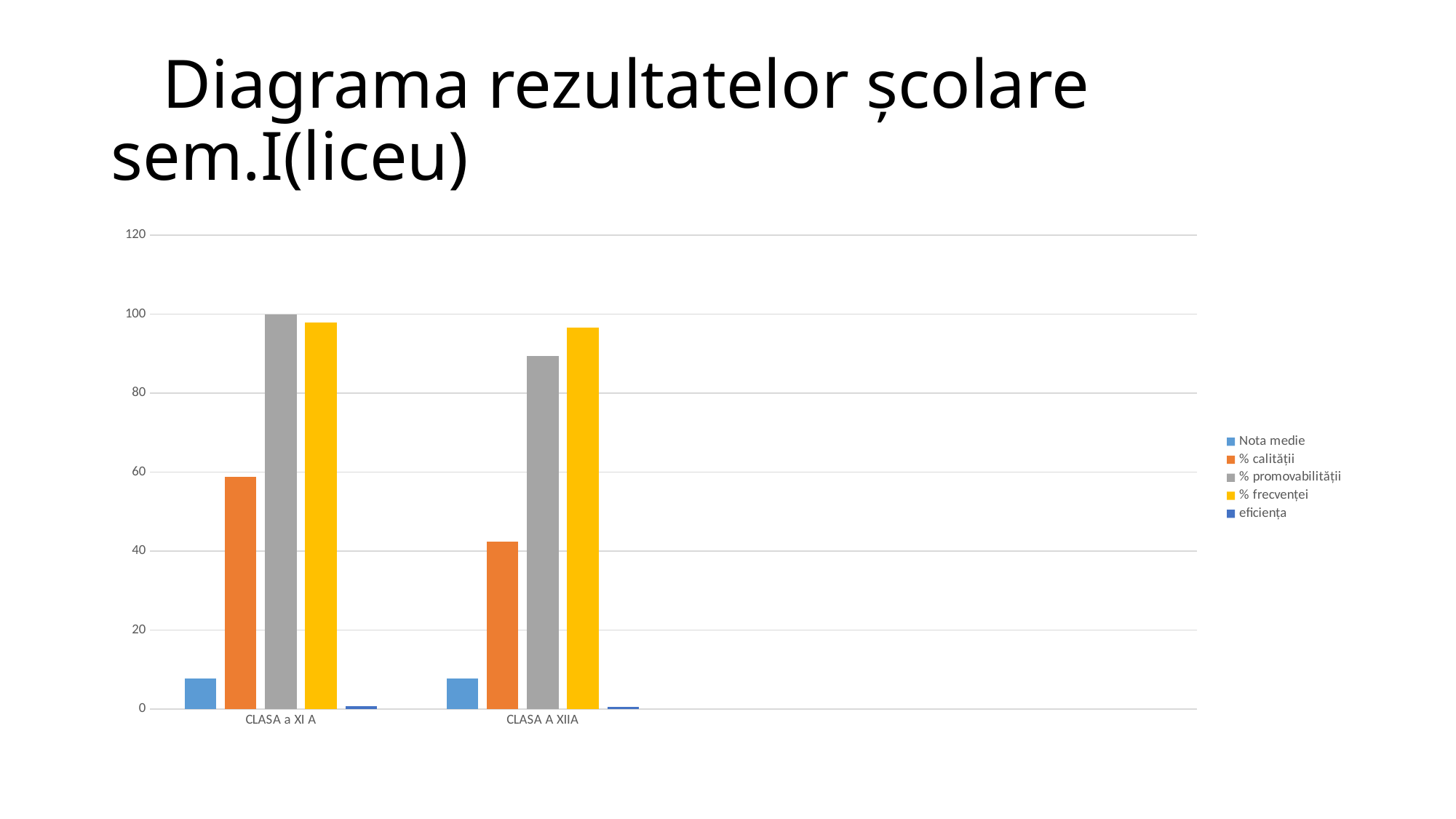
Is the value of Nota medie for CLASA a XI A greater or less than 20? less How many series does the chart legend list? 5 Which class has the higher % calității, CLASA a XI A or CLASA A XIIA? CLASA a XI A What kind of chart is shown on the slide? bar chart Which series has the highest value for CLASA a XI A? % promovabilității Which series has the lowest value for CLASA A XIIA? eficiența What colour are the bars for the % frecvenței series? yellow How many classes (categories) are shown on the x axis of the chart? 2 Is the value of % calității for CLASA A XIIA greater or less than 60? less What is the value of % promovabilității for CLASA a XI A? 100 Is the value of % promovabilității for CLASA A XIIA greater or less than 80? greater